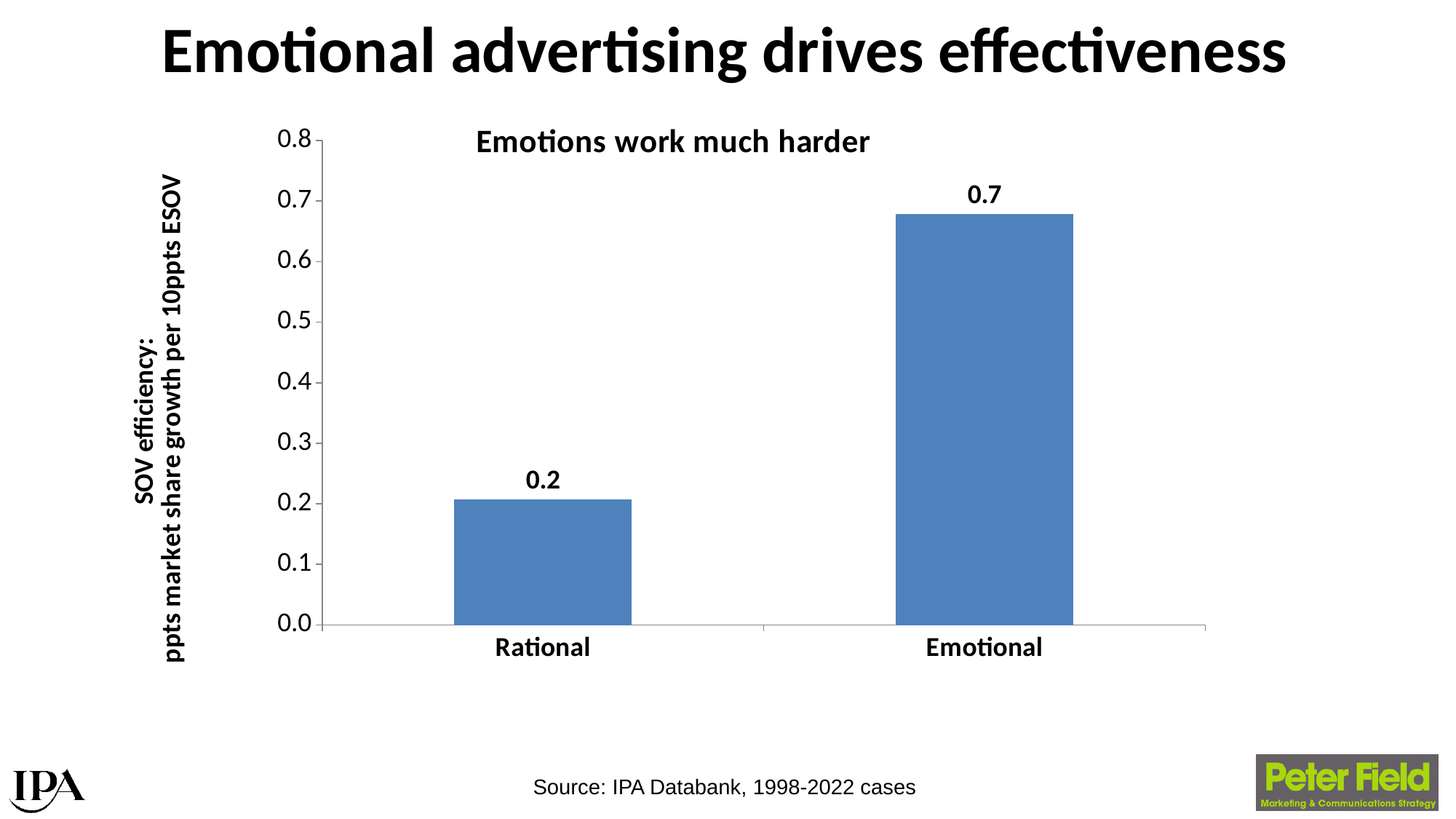
Is the value for Rational greater or less than 0.3? less Is the value for Emotional greater or less than 0.5? greater What is the title of the chart? Emotions work much harder What kind of chart is shown on the slide? Bar chart Which is larger, the value for Rational or the value for Emotional? Emotional Which category has the highest SOV efficiency? Emotional What is the SOV efficiency value for Emotional advertising? 0.7 How many categories are shown on the chart? 2 What is the SOV efficiency value for Rational advertising? 0.2 What is the highest value shown on the y axis? 0.8 Which category has the lowest SOV efficiency? Rational What is the difference between the Emotional and Rational values? 0.5